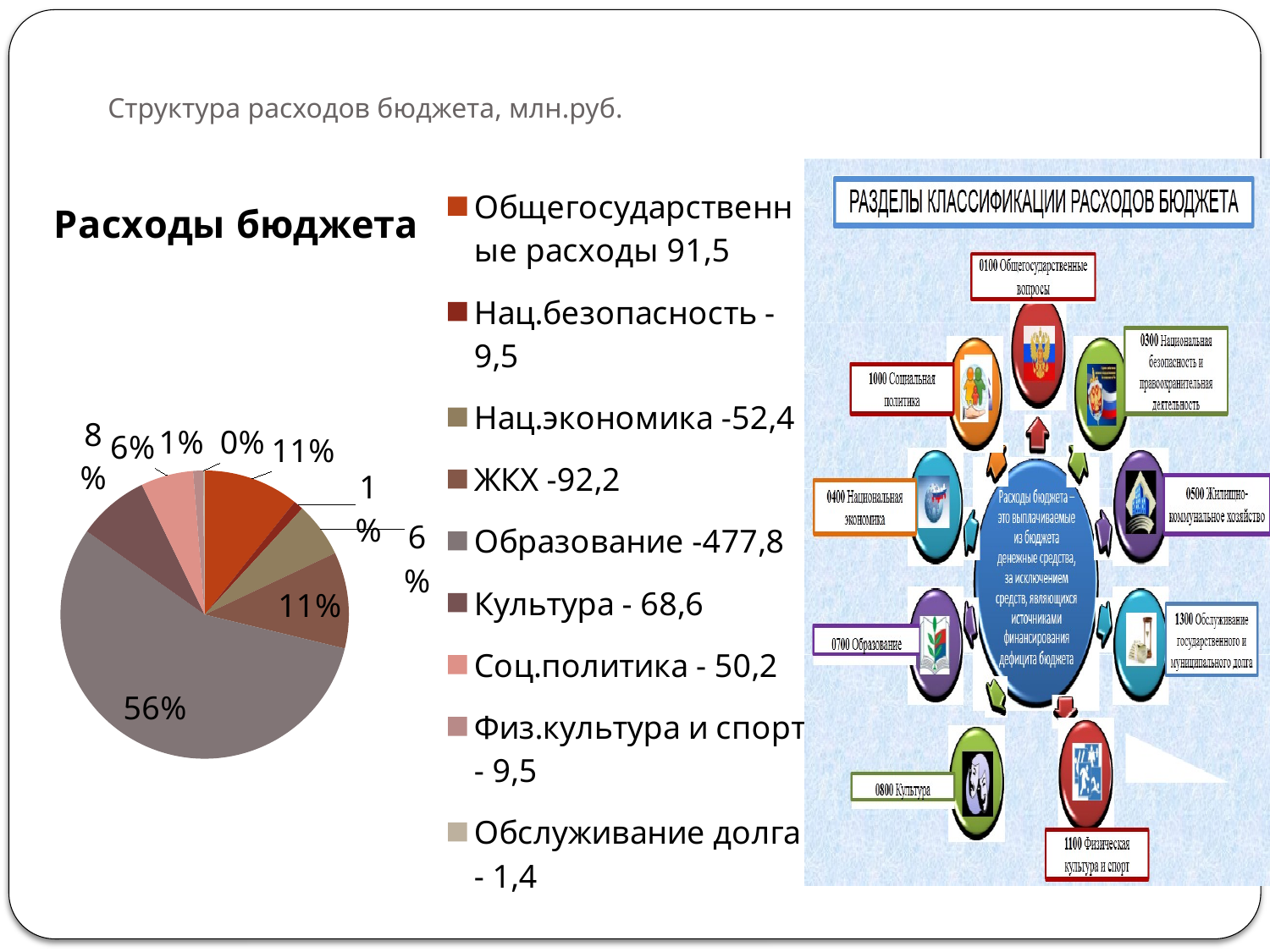
In the 'Расходы бюджета' pie chart, which category has the smallest share? Обслуживание долга According to the legend of the 'Расходы бюджета' chart, what is the value for Соц.политика? 50,2 In the 'Расходы бюджета' chart, what is the difference between the values for Образование (477,8) and ЖКХ (92,2)? 385,6 In the 'Расходы бюджета' pie chart, which category has the largest share? Образование How many categories does the legend of the 'Расходы бюджета' pie chart list? 9 In the 'Расходы бюджета' pie chart, what share of the pie does Образование take? 56% In the 'Расходы бюджета' pie chart, what share is labelled for Культура? 8% According to the legend of the 'Расходы бюджета' chart, what is the value for Образование? 477,8 What is the title of the pie chart on the slide? Расходы бюджета According to the legend of the 'Расходы бюджета' chart, what is the value for ЖКХ? 92,2 In the 'Расходы бюджета' chart, which is larger: the value for ЖКХ or for Общегосударственные расходы? ЖКХ What kind of chart is the 'Расходы бюджета' chart? pie chart